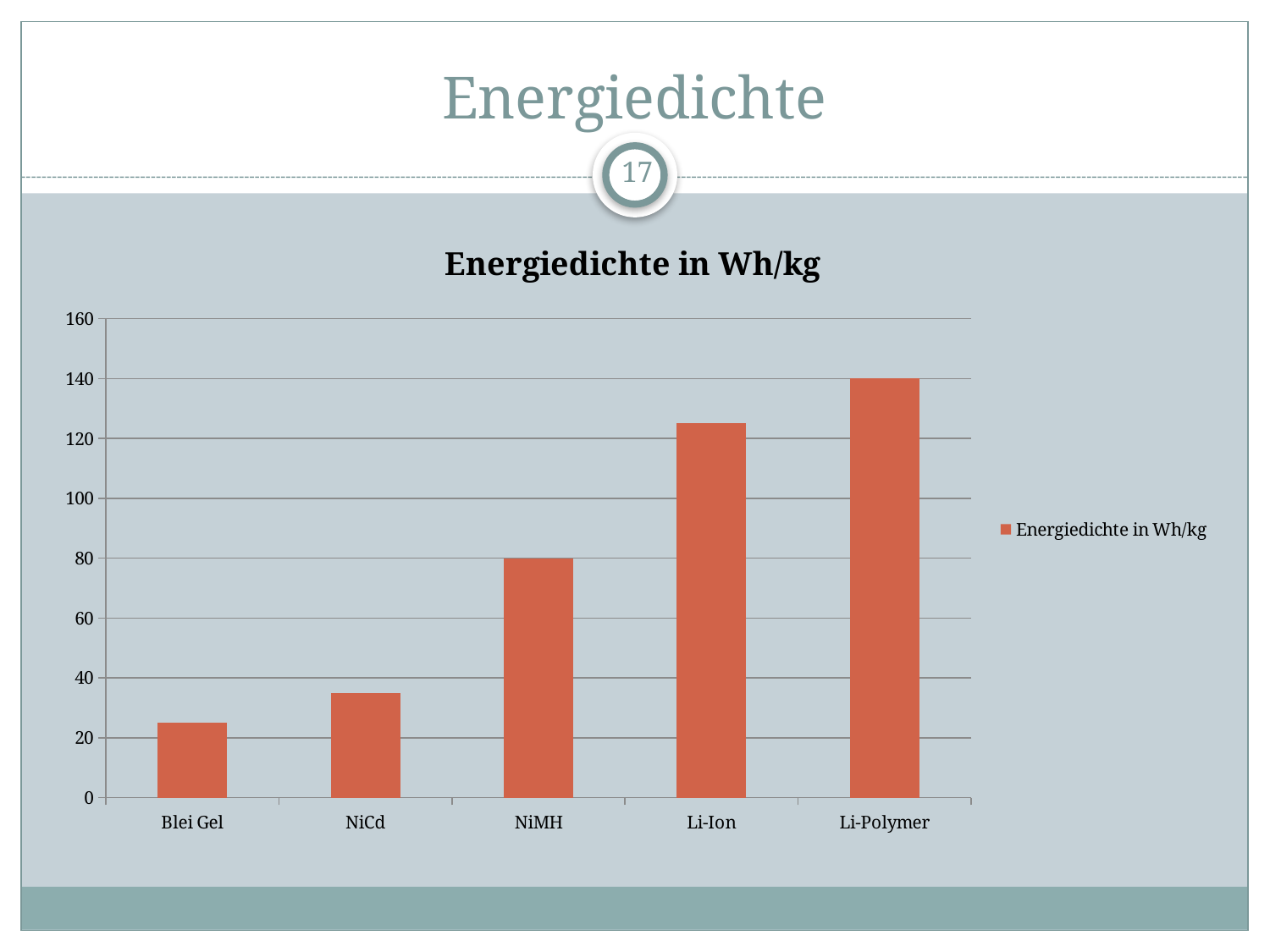
What is the title of the chart? Energiedichte in Wh/kg How many series does the legend list? 1 Which category has the highest energy density in the chart? Li-Polymer What is the value for NiMH? 80 How many categories are shown on the x axis of the chart? 5 Is the value for NiCd greater or less than 40? less Which is larger, the value for Li-Ion or the value for NiMH? Li-Ion What is the difference between the values for Li-Polymer and NiMH? 60 Is the value for Li-Ion greater or less than 120? greater Which category has the lowest energy density in the chart? Blei Gel What is the value for Li-Polymer? 140 What kind of chart is shown on the slide? bar chart